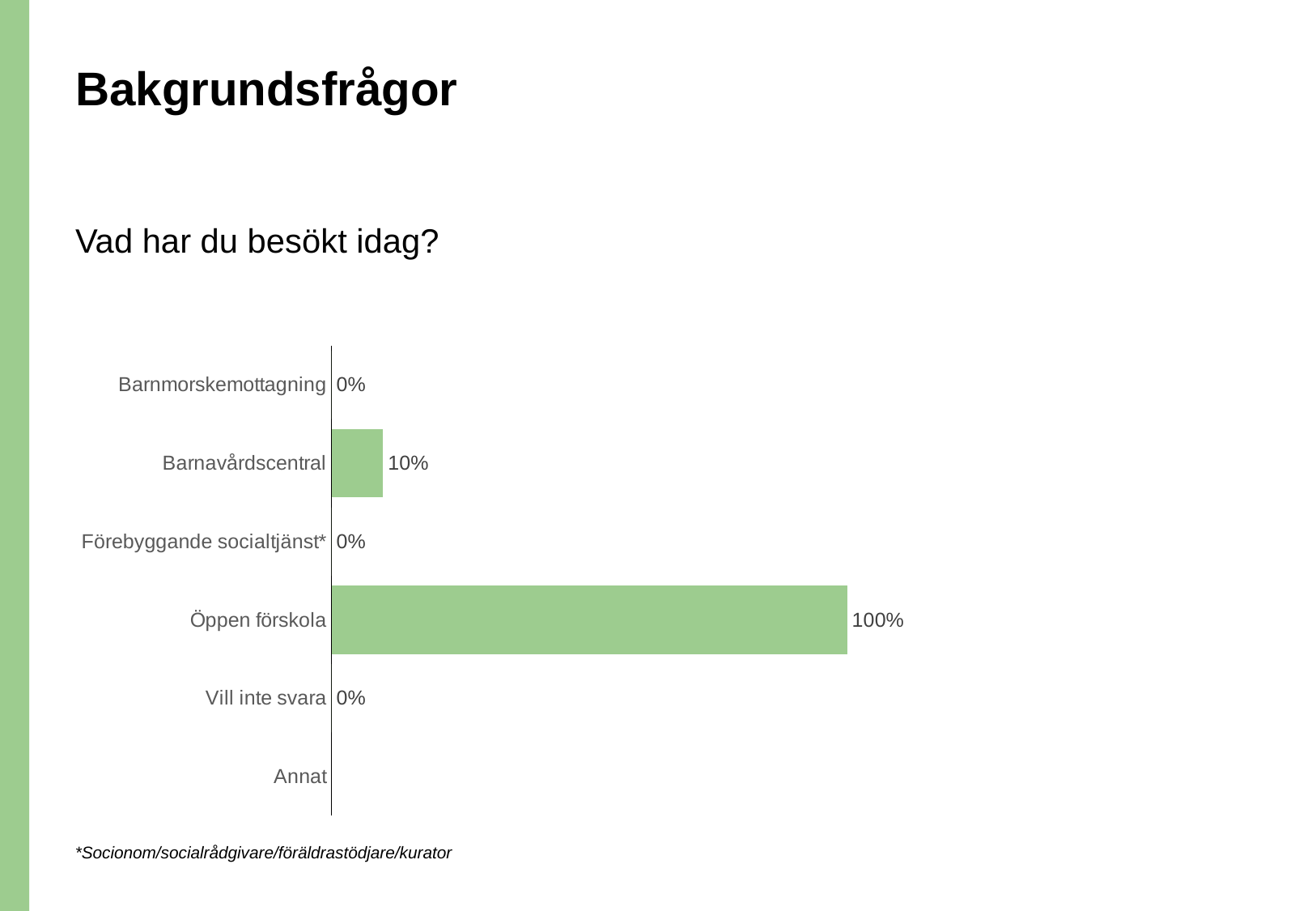
What is the value for Vill inte svara? 0% What is the difference between the values for Öppen förskola and Barnavårdscentral? 90% What is the value for Barnavårdscentral? 10% What question does the chart answer, according to the text above it? Vad har du besökt idag? Which is larger, the value for Barnavårdscentral or the value for Barnmorskemottagning? Barnavårdscentral What kind of chart is shown on the slide? bar chart What is the value for Förebyggande socialtjänst*? 0% What does the asterisk after Förebyggande socialtjänst refer to, according to the footnote? Socionom/socialrådgivare/föräldrastödjare/kurator How many categories are listed on the chart? 6 What is the value for Öppen förskola? 100% Which category has the highest value? Öppen förskola What is the value for Barnmorskemottagning? 0%